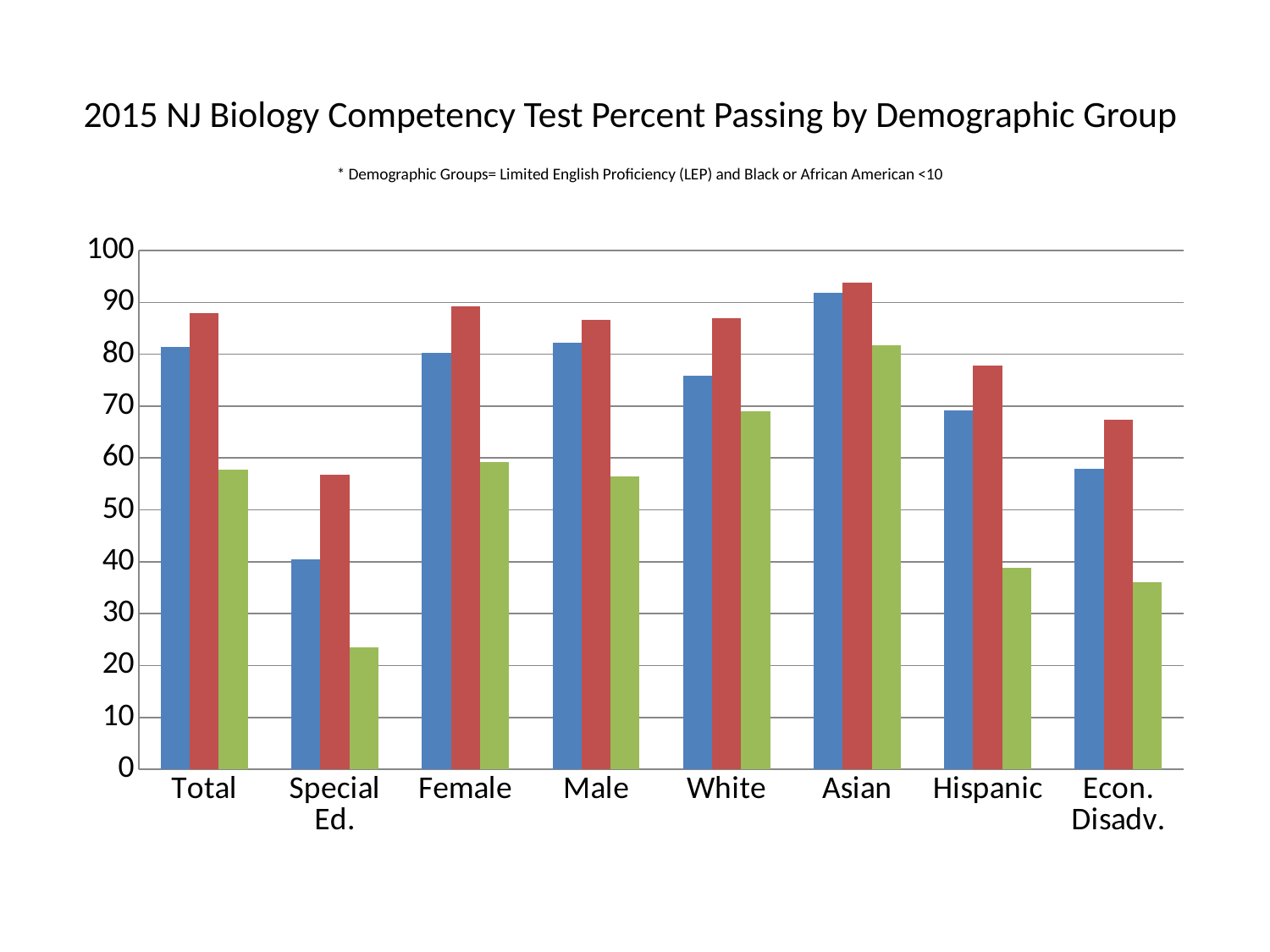
Which demographic group has the lowest green bar? Special Ed. Which demographic group has the highest red bar? Asian Is the green bar for Econ. Disadv. greater or less than 40? less How many demographic groups are shown on the x axis? 8 Is the red bar for Total greater or less than 80? greater How many bars (series) are plotted for each demographic group? 3 Which is larger, the green bar for White or the green bar for Male? White Is the green bar for Special Ed. greater or less than 30? less What kind of chart is shown on the slide? bar chart Which demographic group has the lowest blue bar? Special Ed. What is the title of the chart? 2015 NJ Biology Competency Test Percent Passing by Demographic Group